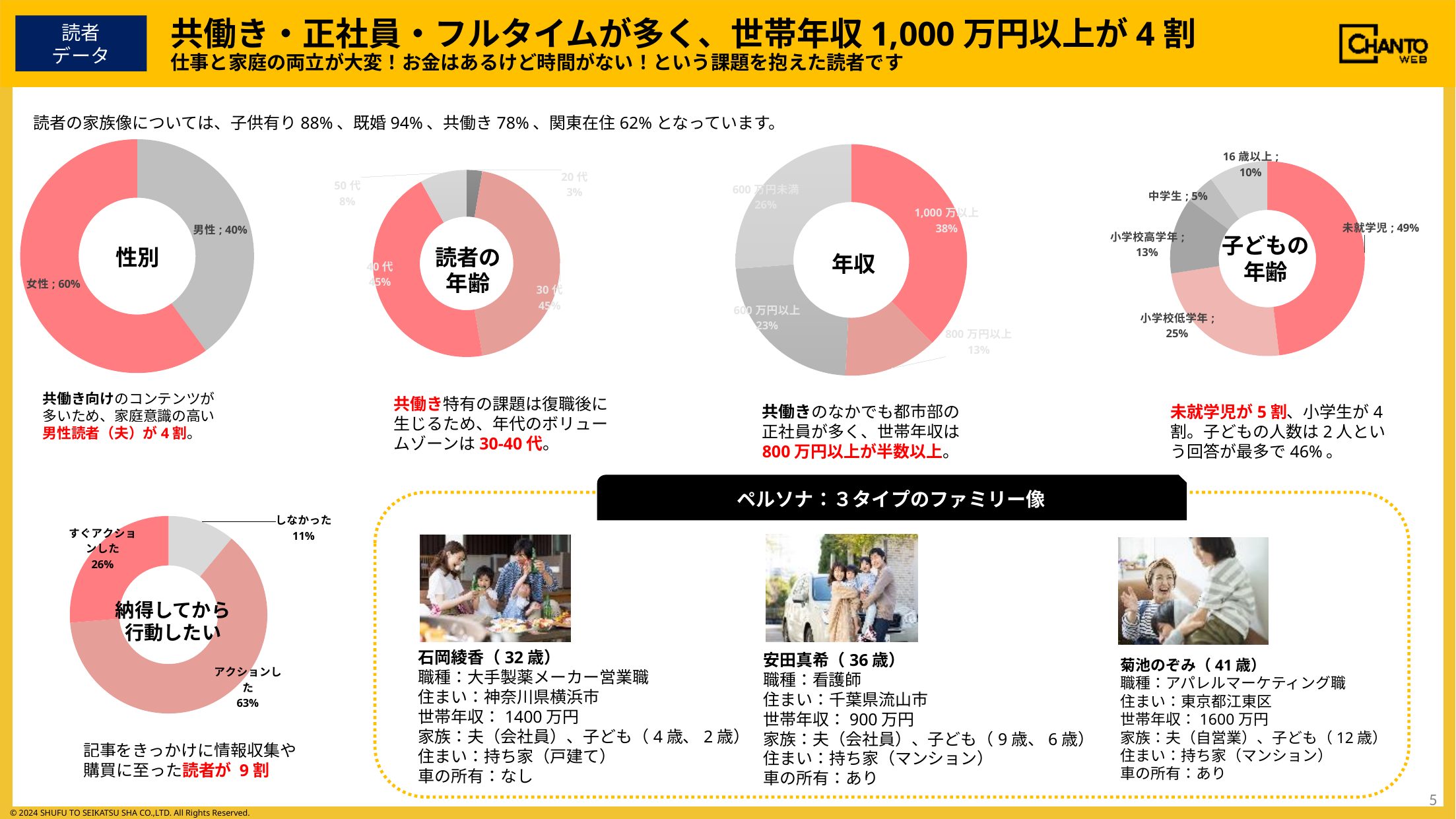
In the 性別 chart, what is the value for 女性? 60% In the 納得してから行動したい chart, how many categories are shown? 3 In the 性別 chart, what is the value for 男性? 40% In the 納得してから行動したい chart, which is larger, すぐアクションした or しなかった? すぐアクションした In the 子どもの年齢 chart, which category has the highest value? 未就学児 What kind of chart is the 性別 chart? Donut (pie) chart In the 子どもの年齢 chart, what is the value for 小学校低学年? 25% In the 年収 chart, what is the value for 1,000 万以上? 38% In the 年収 chart, what is the difference between 600 万円未満 and 600 万円以上? 3% In the 読者の年齢 chart, what is the value for 50 代? 8% In the 年収 chart, which category has the lowest value? 800 万円以上 In the 読者の年齢 chart, what is the value for 20 代? 3%